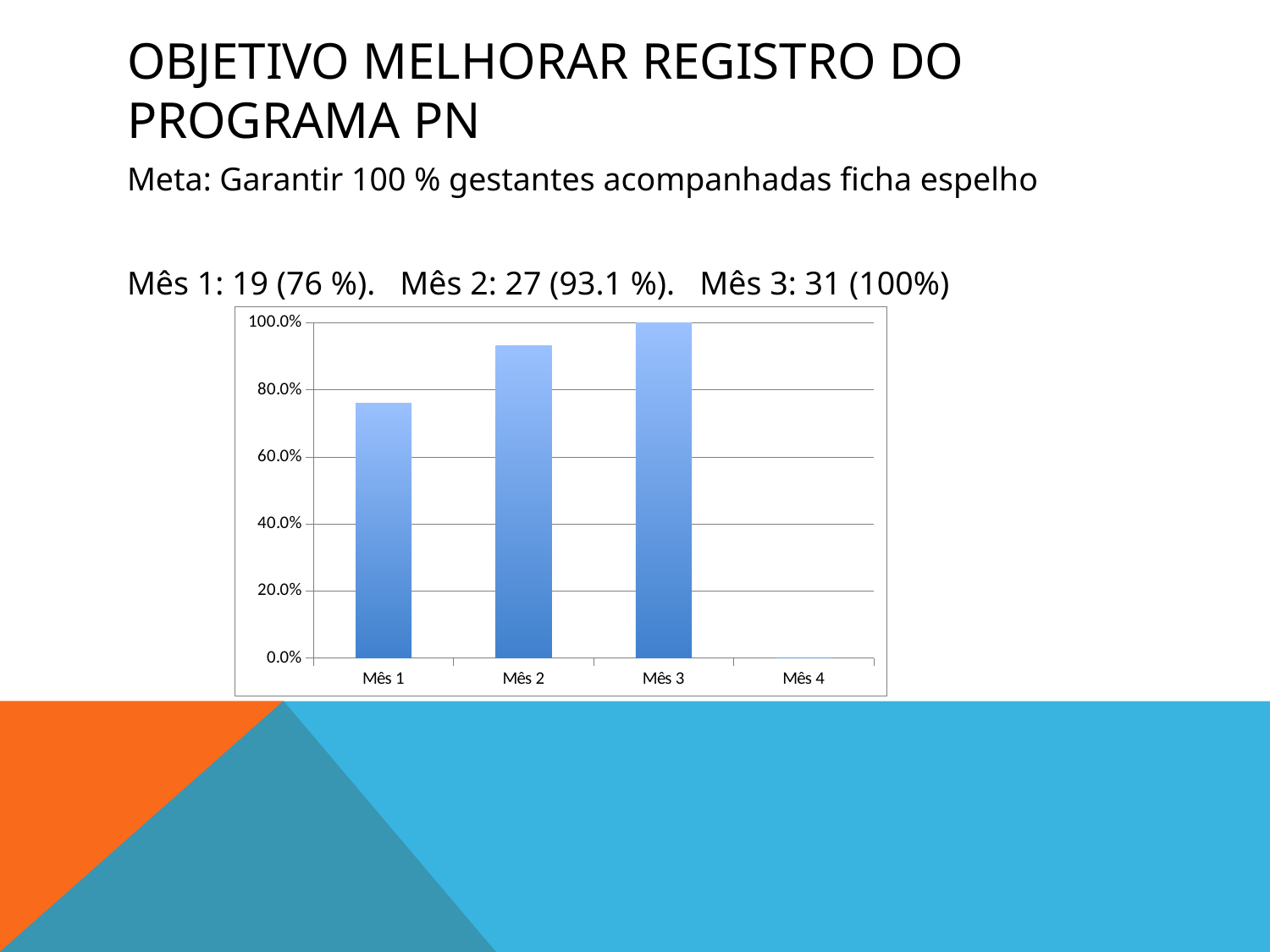
Do the bar values rise or fall from Mês 1 to Mês 3? rise What is the value for Mês 3 in the chart? 100% What percentage is shown for Mês 1? 76 % Is the value for Mês 1 greater or less than 80.0%? less Which is larger, the value for Mês 1 or the value for Mês 2? Mês 2 How many categories are shown on the x axis of the chart? 4 Among the months with a plotted bar, which has the lowest value? Mês 1 What kind of chart is shown on the slide? bar chart Is the value for Mês 2 greater or less than 80.0%? greater Which month has the highest bar in the chart? Mês 3 How many bars are actually plotted in the chart? 3 Which category on the x axis has no bar plotted? Mês 4